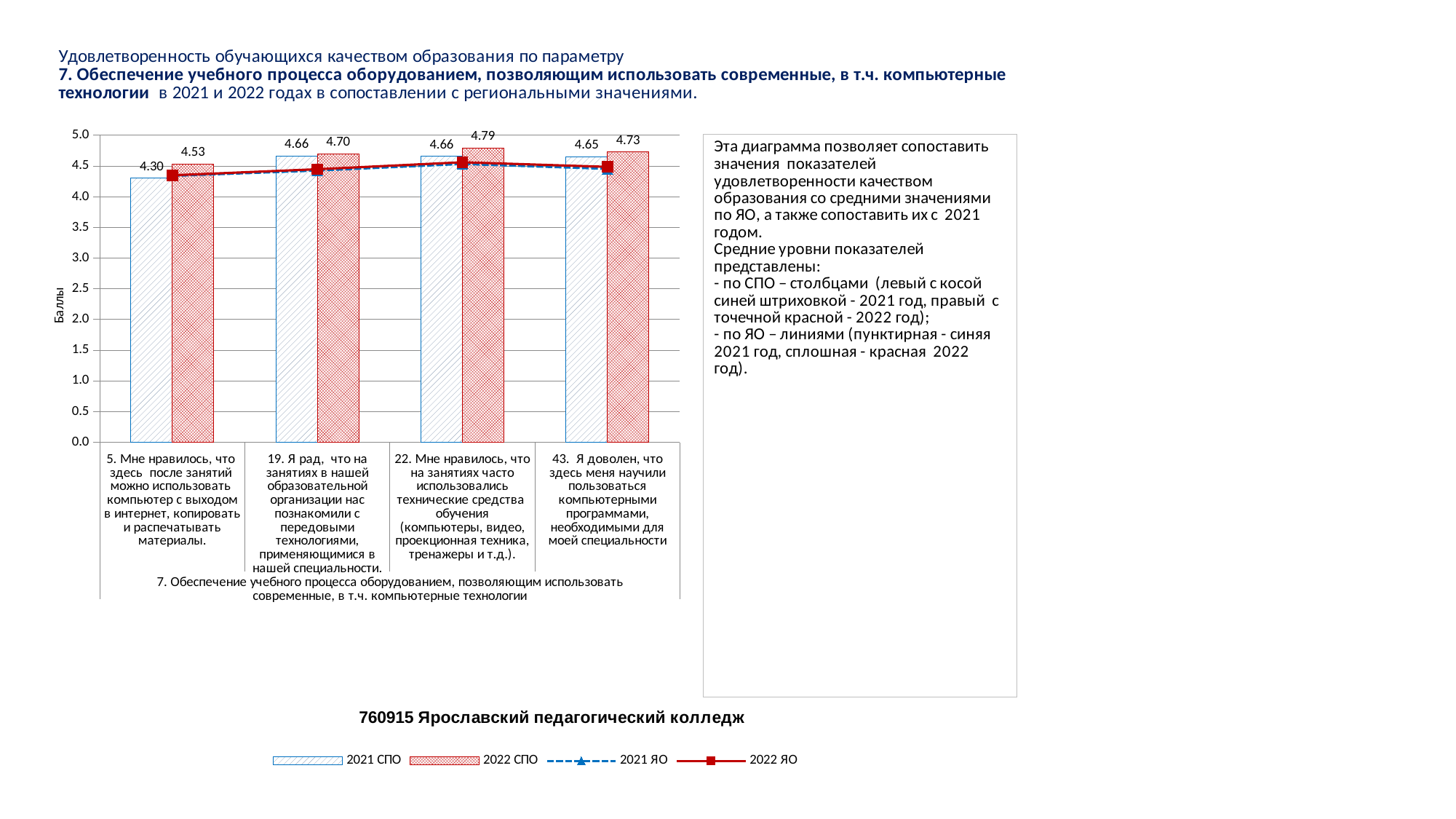
What is the 2021 СПО value for item 5 ("Мне нравилось, что здесь после занятий можно использовать компьютер...")? 4.30 Which item has the lowest 2021 СПО value? 5. Мне нравилось, что здесь после занятий можно использовать компьютер с выходом в интернет What is the 2022 СПО value for item 22 ("Мне нравилось, что на занятиях часто использовались технические средства обучения...")? 4.79 How many items (categories) are shown on the x axis? 4 What type of chart is used for the СПО series? Bar chart How many series does the legend list? 4 What is the 2022 СПО value for item 43 ("Я доволен, что здесь меня научили пользоваться компьютерными программами...")? 4.73 What is the difference between the 2022 СПО and 2021 СПО values for item 22? 0.13 For item 19, which is larger: the 2021 СПО value or the 2022 СПО value? 2022 СПО Is the 2021 СПО value for item 5 greater or less than 4.5? less What is the difference between the 2022 СПО and 2021 СПО values for item 5? 0.23 Which item has the highest 2022 СПО value? 22. Мне нравилось, что на занятиях часто использовались технические средства обучения